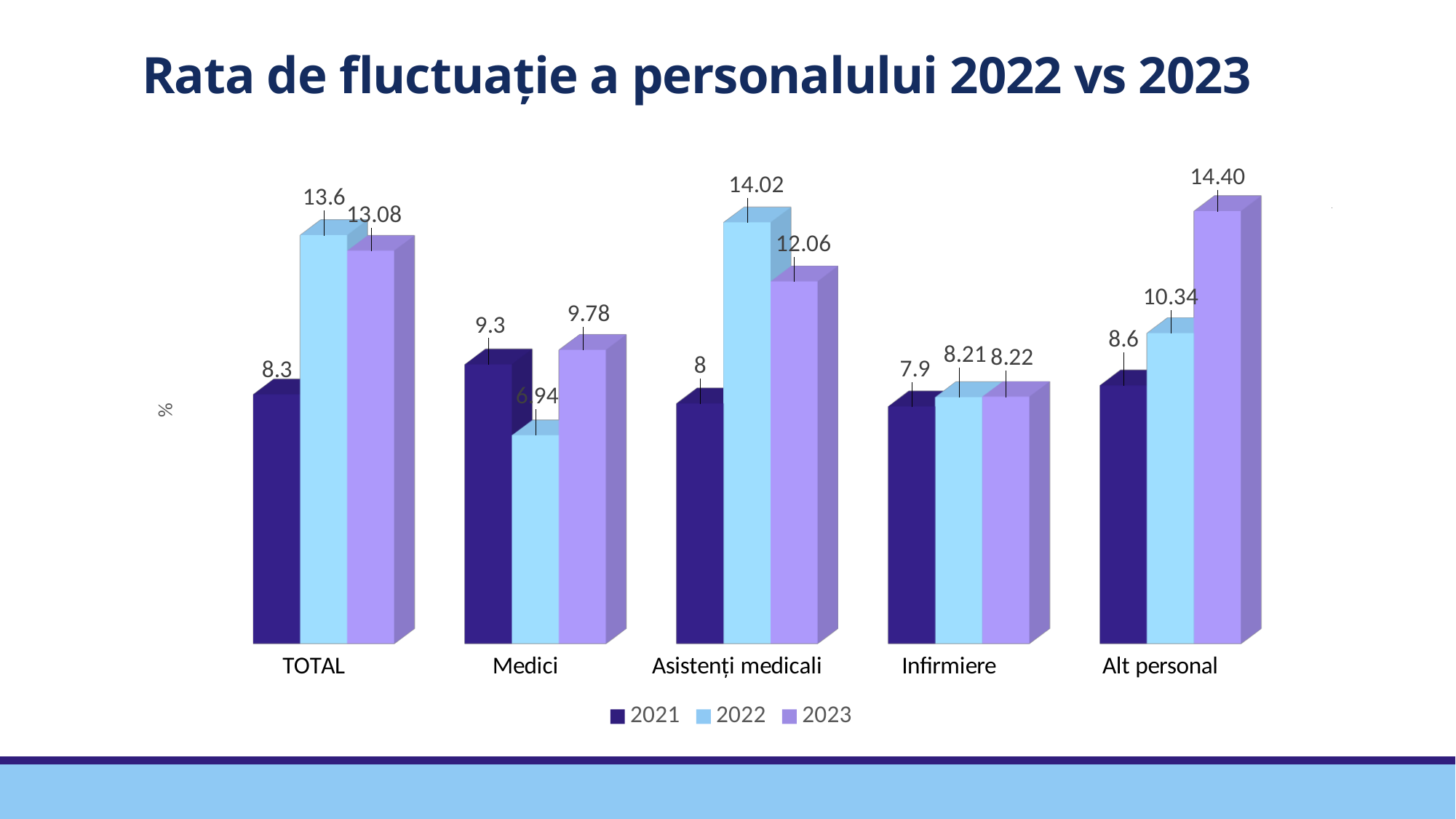
What is the value for Alt personal in 2023? 14.40 What is the value for TOTAL in 2021? 8.3 Which category has the highest value in the 2023 series? Alt personal Which category has the lowest value in the 2021 series? Infirmiere How many series does the legend list? 3 What is the difference between the 2022 and 2021 values for TOTAL? 5.3 How many categories are shown on the x axis? 5 Which is larger for Asistenți medicali, the 2022 value or the 2023 value? 2022 What is the value for Medici in 2022? 6.94 What is the value for Asistenți medicali in 2022? 14.02 What is the difference between the 2023 and 2022 values for Alt personal? 4.06 What kind of chart is shown on the slide? Bar chart